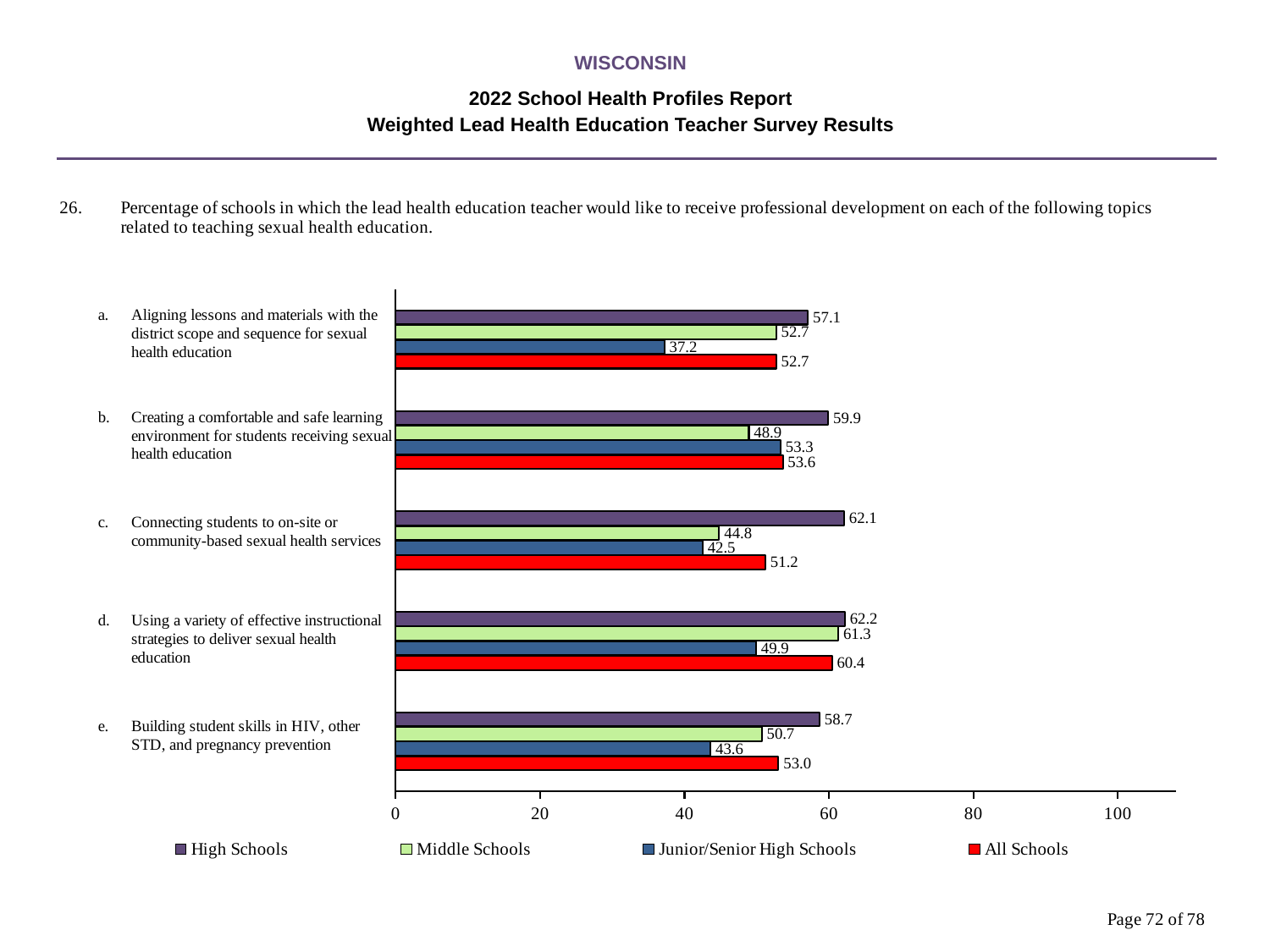
Which topic has the lowest Junior/Senior High Schools value? a. Aligning lessons and materials with the district scope and sequence for sexual health education What kind of chart is shown on the slide? bar chart What is the All Schools value for topic d, using a variety of effective instructional strategies to deliver sexual health education? 60.4 For topic b, creating a comfortable and safe learning environment, which is larger: the Middle Schools value or the Junior/Senior High Schools value? Junior/Senior High Schools How many topics are listed on the chart? 5 What is the difference between the High Schools and Middle Schools values for topic c, connecting students to on-site or community-based sexual health services? 17.3 How many series does the legend list? 4 What is the value for Junior/Senior High Schools for topic c, connecting students to on-site or community-based sexual health services? 42.5 Which topic has the highest High Schools value? d. Using a variety of effective instructional strategies to deliver sexual health education What is the Middle Schools value for topic e, building student skills in HIV, other STD, and pregnancy prevention? 50.7 Is the Junior/Senior High Schools value for topic a greater or less than 40? less What is the value for High Schools for topic a, aligning lessons and materials with the district scope and sequence for sexual health education? 57.1